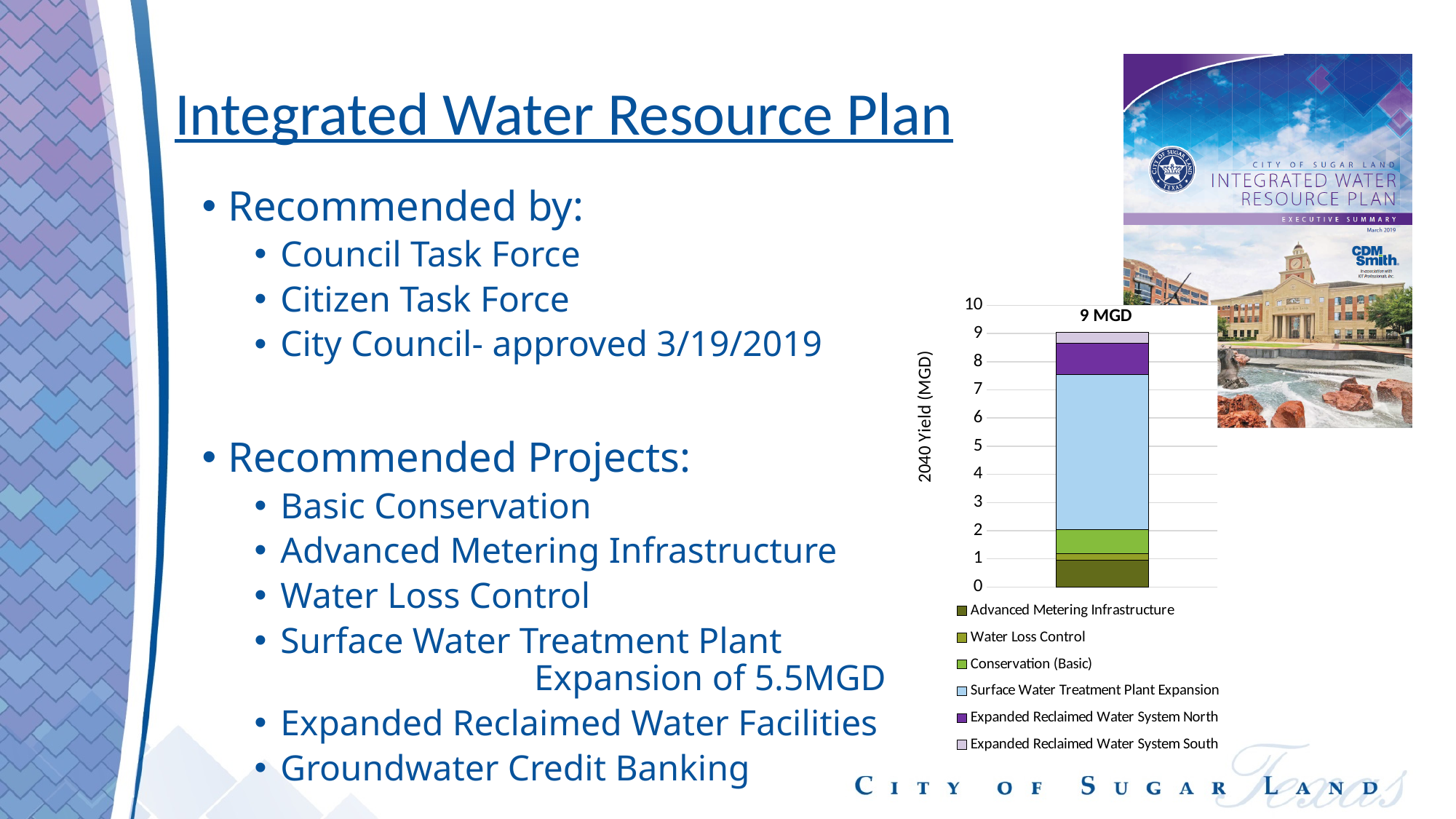
How many series does the chart's legend list? 6 Is the Advanced Metering Infrastructure segment greater or less than 2 MGD? less What kind of chart is shown on the slide? Stacked bar chart Is the Surface Water Treatment Plant Expansion segment greater or less than 4 MGD? greater Which series is shown in light blue in the chart? Surface Water Treatment Plant Expansion What is the label of the chart's vertical axis? 2040 Yield (MGD) How many bars are plotted in the chart? 1 Which series makes up the largest segment of the stacked bar? Surface Water Treatment Plant Expansion Which series makes up the smallest segment of the stacked bar? Water Loss Control Which series forms the bottom segment of the stacked bar? Advanced Metering Infrastructure What total value is labelled at the top of the stacked bar? 9 MGD Which segment is larger: Surface Water Treatment Plant Expansion or Expanded Reclaimed Water System North? Surface Water Treatment Plant Expansion